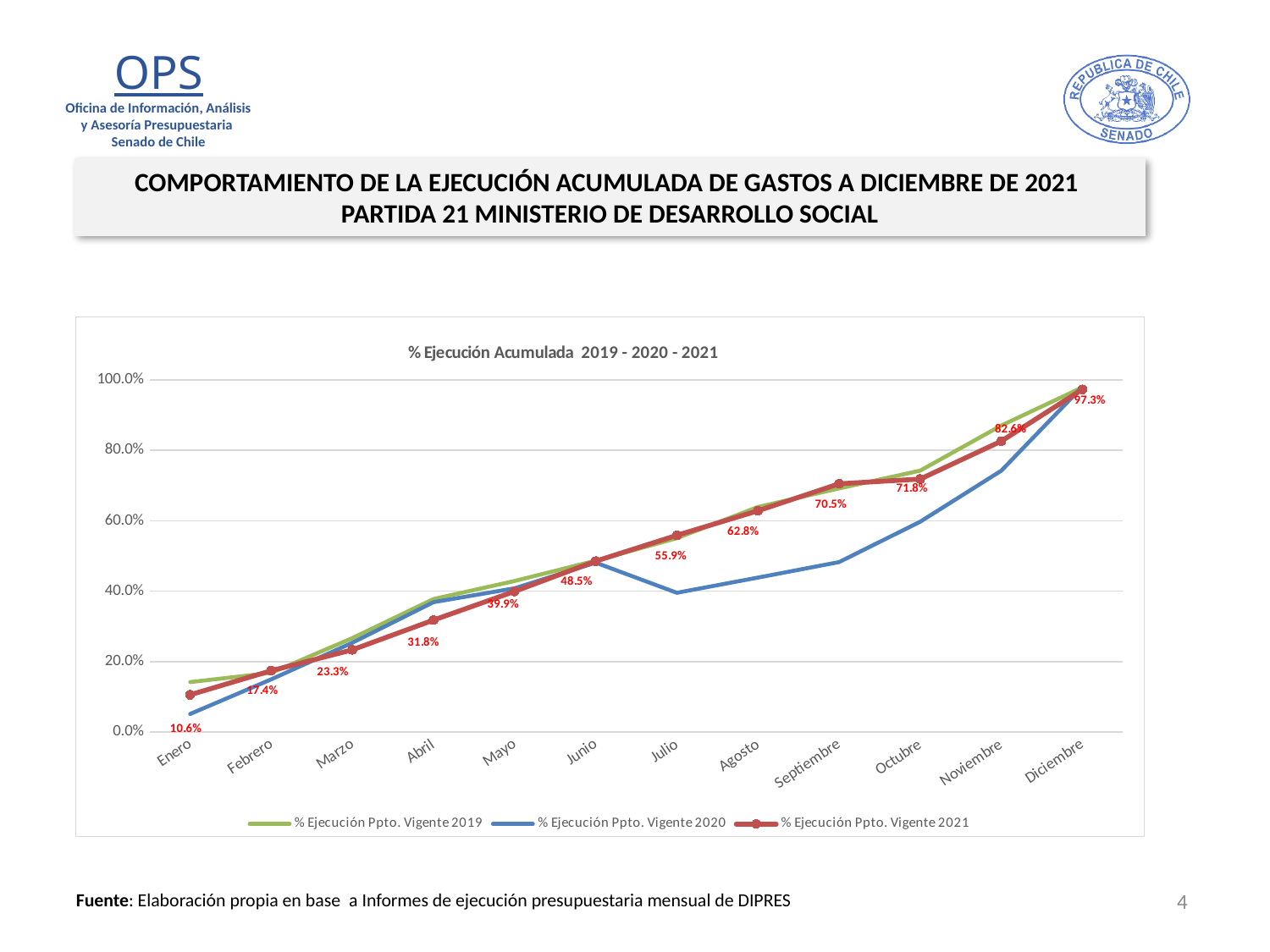
Is the value for % Ejecución Ppto. Vigente 2020 in Julio greater or less than 60.0%? less What is the difference between the % Ejecución Ppto. Vigente 2021 values for Noviembre and Octubre? 10.8% How many months are shown on the x axis? 12 Does the % Ejecución Ppto. Vigente 2021 series rise or fall from Enero to Diciembre? rise What is the value for % Ejecución Ppto. Vigente 2021 in Junio? 48.5% In which month is the % Ejecución Ppto. Vigente 2021 series lowest? Enero In Septiembre, which is larger: % Ejecución Ppto. Vigente 2021 or % Ejecución Ppto. Vigente 2020? % Ejecución Ppto. Vigente 2021 How many series does the legend list? 3 What is the title of the chart? % Ejecución Acumulada 2019 - 2020 - 2021 What type of chart is shown on the slide? line chart What is the value for % Ejecución Ppto. Vigente 2021 in Diciembre? 97.3% What is the value for % Ejecución Ppto. Vigente 2021 in Enero? 10.6%